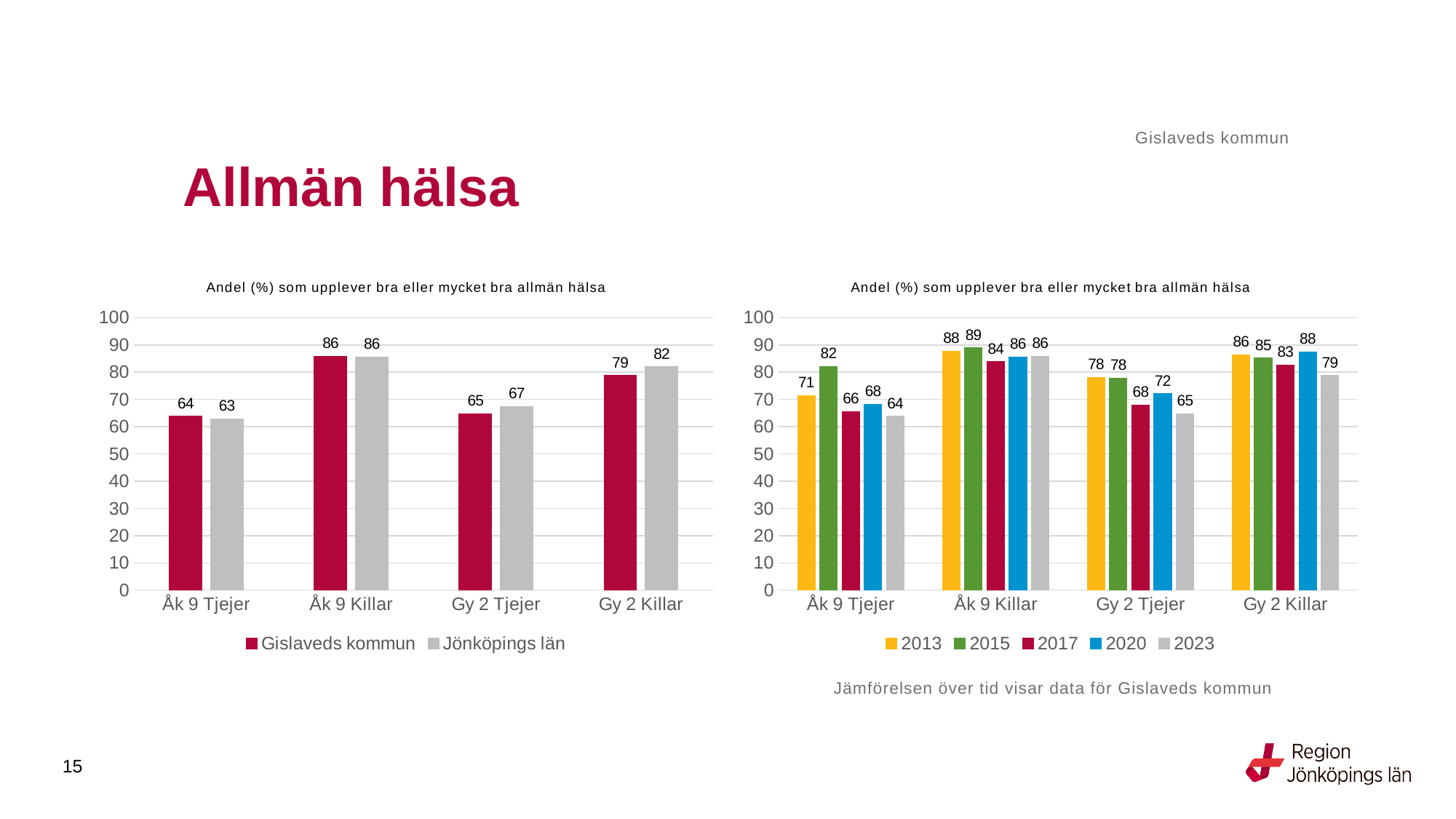
In the left chart, which category has the lowest value for Jönköpings län? Åk 9 Tjejer In the left chart, how many series does the legend list? 2 In the left chart, what is the value for Jönköpings län for Gy 2 Killar? 82 In the right chart, how many series does the legend list? 5 What kind of chart is the right chart? Bar chart In the right chart, what is the value for 2015 for Åk 9 Tjejer? 82 In the right chart, which year has the highest value for Gy 2 Killar? 2020 In the right chart, what is the difference between the 2015 and 2023 values for Åk 9 Tjejer? 18 In the right chart, which is larger for Åk 9 Tjejer: the value for 2013 or the value for 2017? 2013 In the left chart, what is the value for Gislaveds kommun for Åk 9 Killar? 86 In the left chart, what is the difference between Jönköpings län and Gislaveds kommun for Gy 2 Killar? 3 In the right chart, what is the value for 2023 for Gy 2 Tjejer? 65